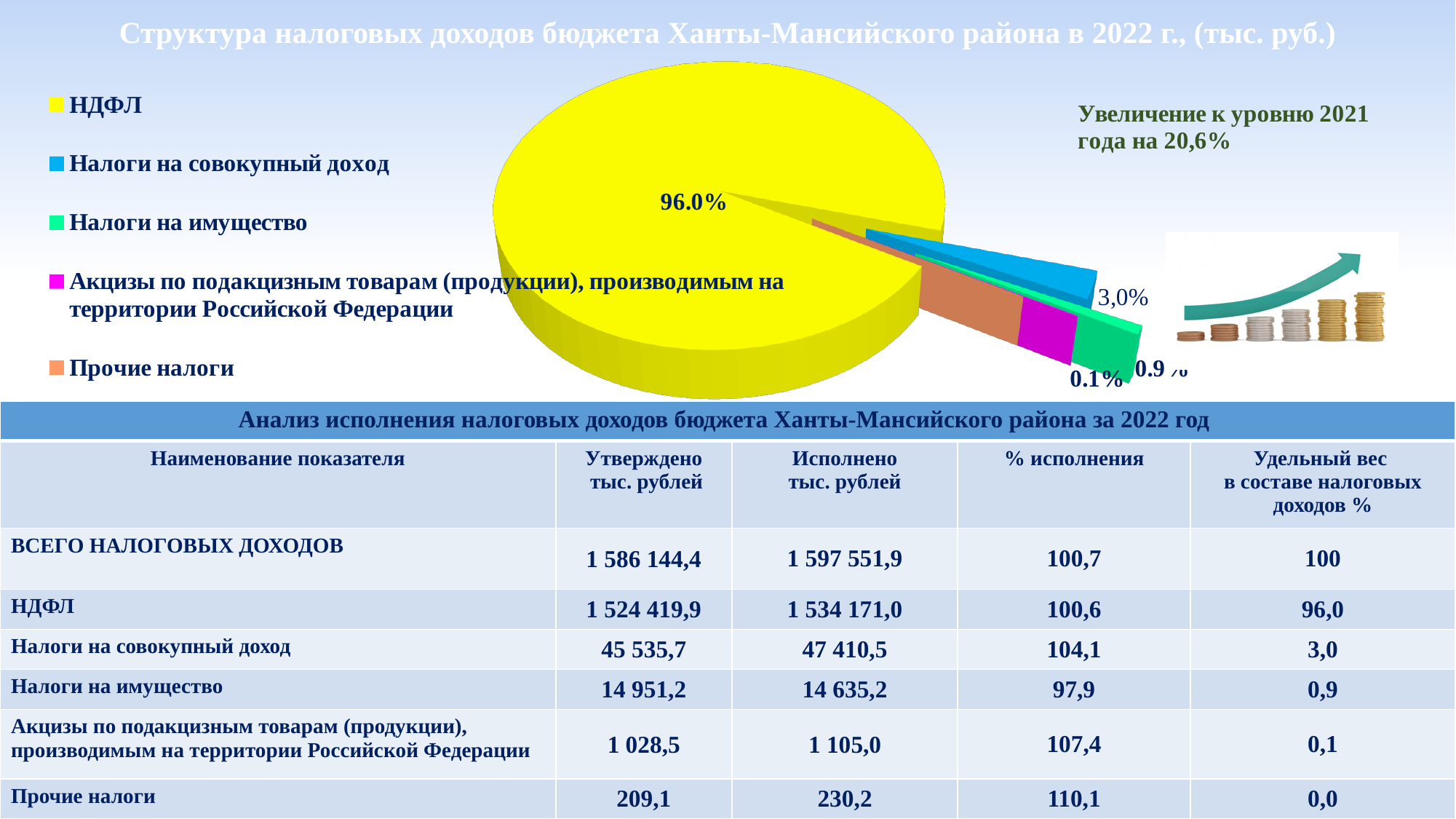
What kind of chart is shown on the slide? pie chart What colour is the НДФЛ slice in the pie chart? yellow Which is larger in the pie chart: Налоги на совокупный доход or Налоги на имущество? Налоги на совокупный доход How many categories does the legend of the pie chart list? 5 Which is larger in the pie chart: НДФЛ or Налоги на совокупный доход? НДФЛ What is the value shown for Акцизы по подакцизным товарам (продукции), производимым на территории Российской Федерации in the pie chart? 0.1% What is the title of the pie chart? Структура налоговых доходов бюджета Ханты-Мансийского района в 2022 г., (тыс. руб.) What is the value shown for Налоги на совокупный доход in the pie chart? 3,0% What is the value shown for Налоги на имущество in the pie chart? 0.9% By how many percentage points does the НДФЛ share exceed the Налоги на совокупный доход share in the pie chart? 93.0 percentage points What share of the pie does НДФЛ hold? 96.0% Which category has the largest slice of the pie? НДФЛ